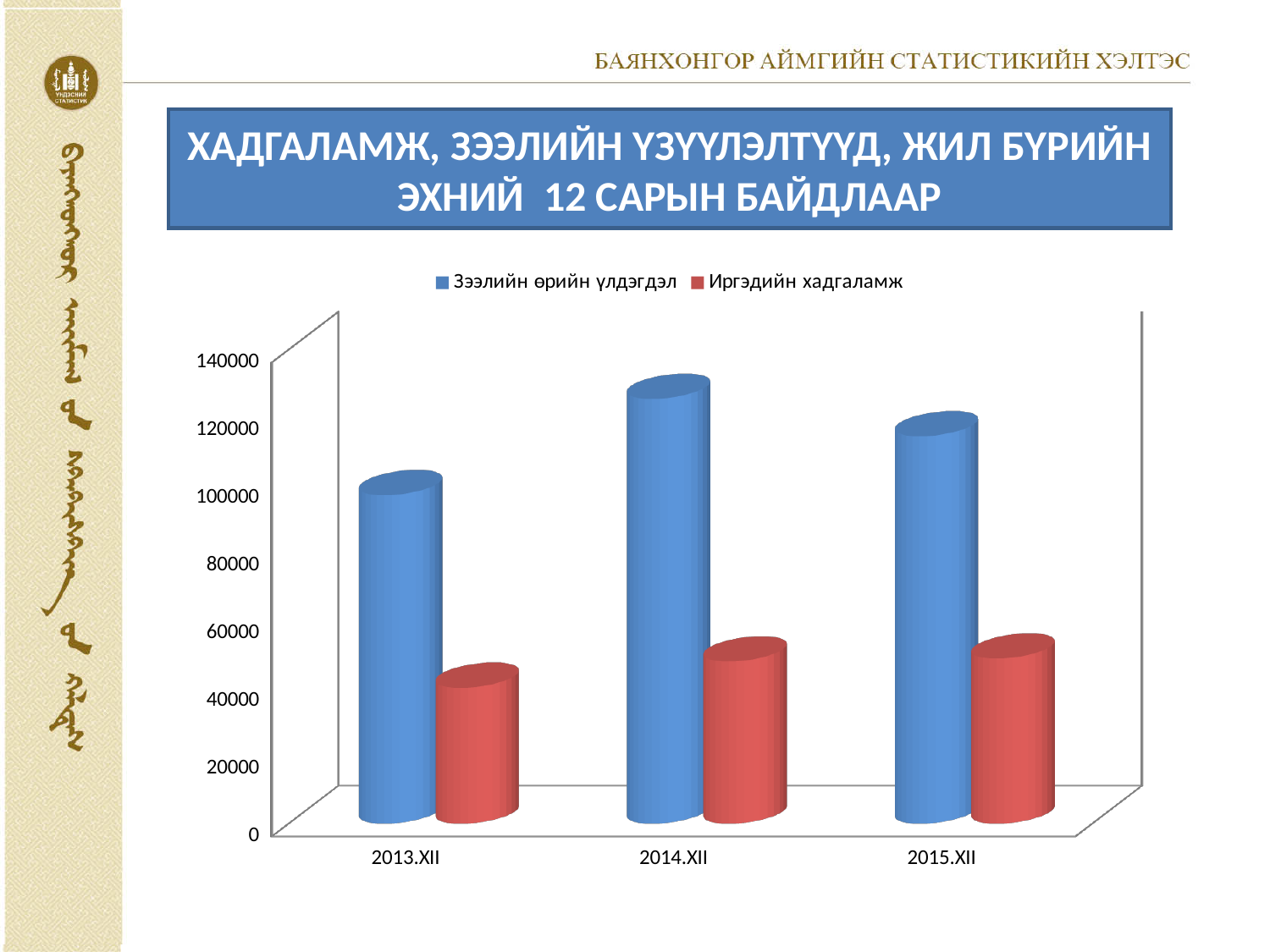
Is the value for Иргэдийн хадгаламж in 2015.XII greater or less than 20000? greater Which series is shown in red? Иргэдийн хадгаламж What kind of chart is shown on the slide? bar chart Is the value for Зээлийн өрийн үлдэгдэл in 2013.XII greater or less than 120000? less Does the value for Иргэдийн хадгаламж rise or fall from 2013.XII to 2015.XII? rise In which period is the value for Иргэдийн хадгаламж lowest? 2013.XII In which period is the value for Зээлийн өрийн үлдэгдэл highest? 2014.XII Is the value for Иргэдийн хадгаламж in 2013.XII greater or less than 60000? less How many series does the legend list? 2 How many categories are shown on the x axis? 3 In 2013.XII, which is larger: Зээлийн өрийн үлдэгдэл or Иргэдийн хадгаламж? Зээлийн өрийн үлдэгдэл